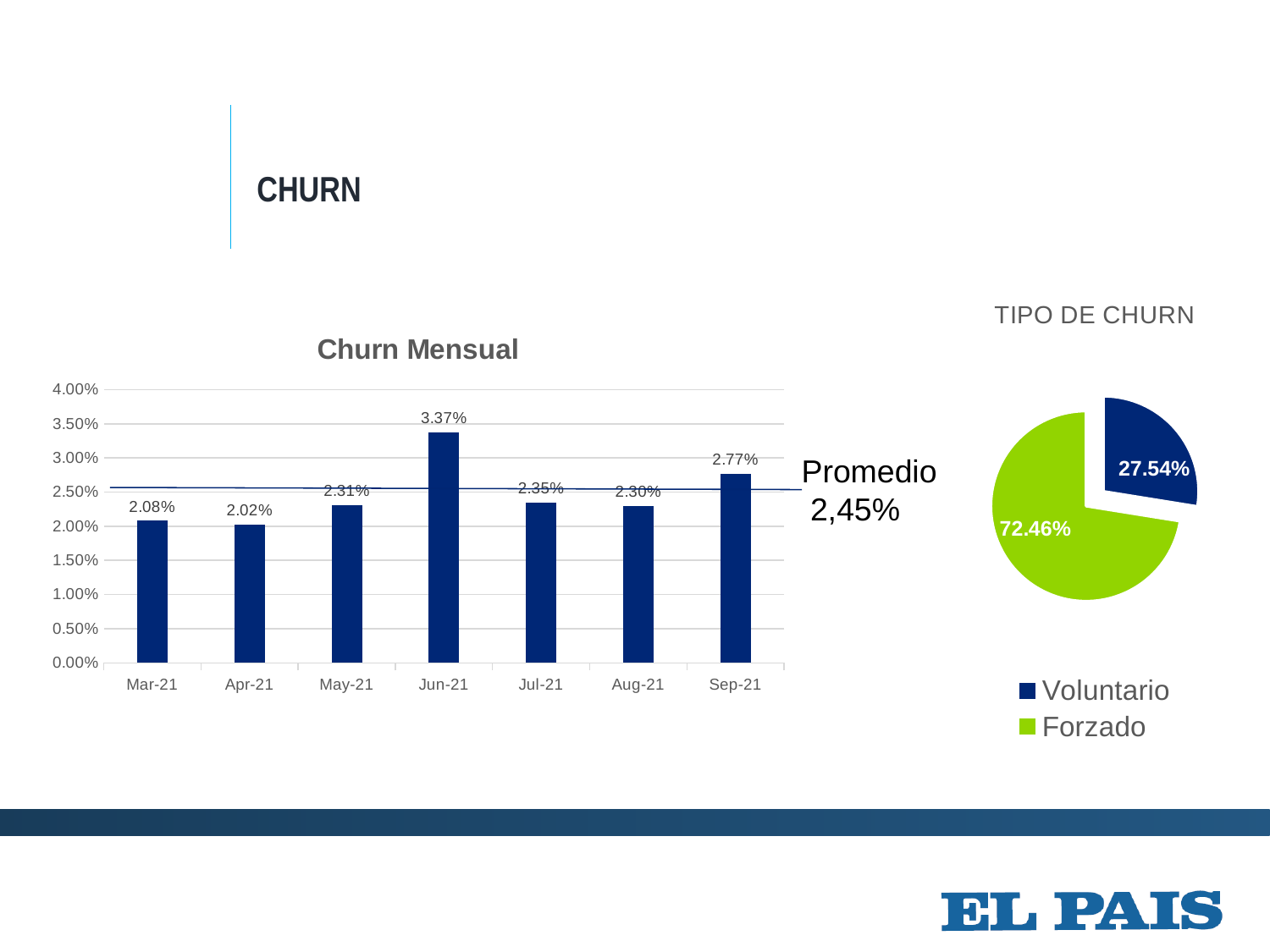
In the TIPO DE CHURN pie chart, what share is Forzado? 72.46% In the Churn Mensual chart, which month has the lowest churn? Apr-21 In the Churn Mensual chart, what is the value for Jun-21? 3.37% In the Churn Mensual chart, what is the value for Apr-21? 2.02% In the TIPO DE CHURN pie chart, how many entries does the legend list? 2 In the Churn Mensual chart, which is larger, the value for May-21 or the value for Aug-21? May-21 In the Churn Mensual chart, how many months are shown on the x axis? 7 In the Churn Mensual chart, what is the difference between the values for Jun-21 and Sep-21? 0.60% What kind of chart is the Churn Mensual chart? Bar chart In the Churn Mensual chart, what average (Promedio) value is shown next to the horizontal line? 2,45% In the Churn Mensual chart, which month has the highest churn? Jun-21 In the TIPO DE CHURN pie chart, what share is Voluntario? 27.54%